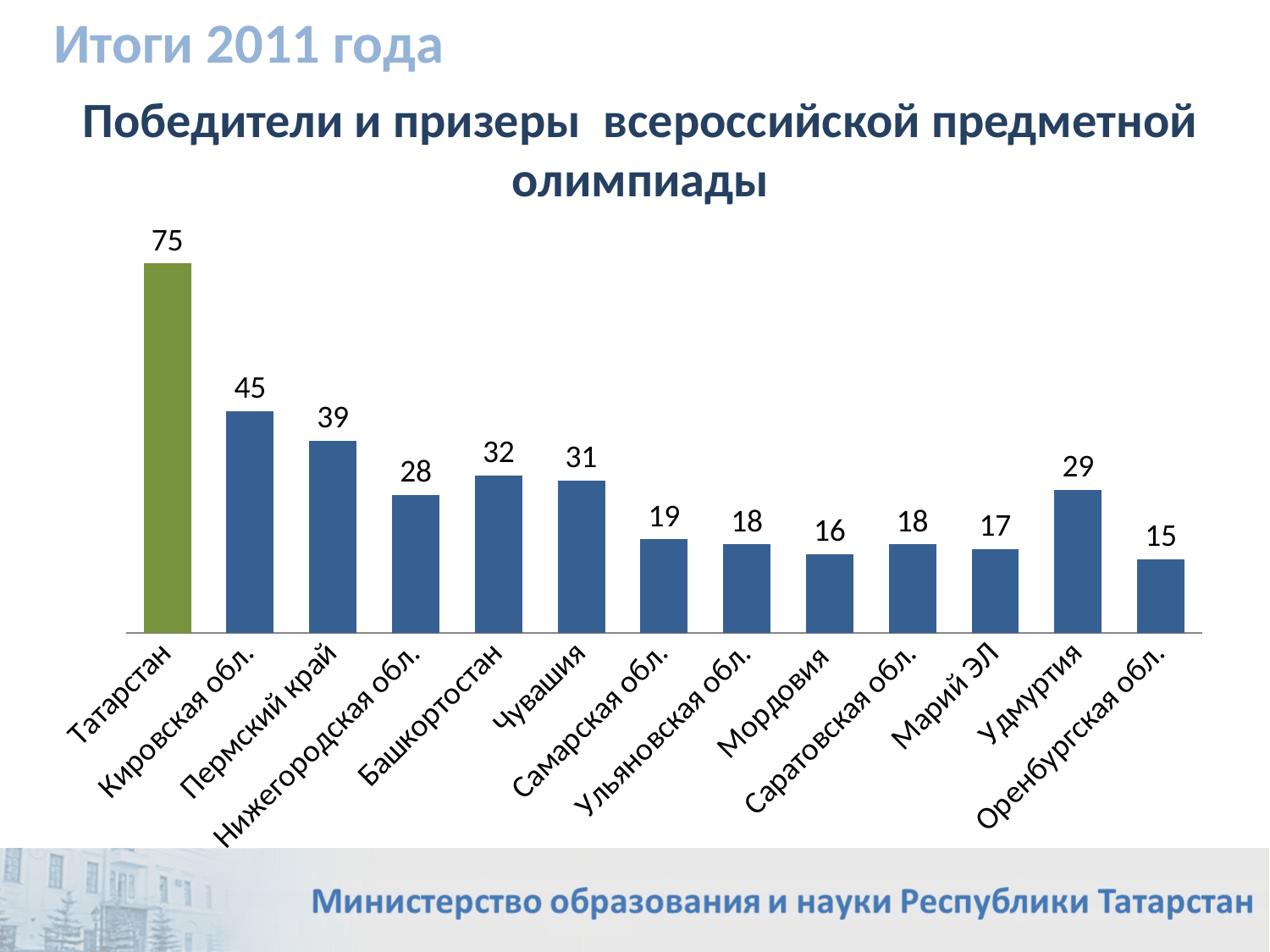
How many regions are shown on the chart? 13 What is the value for Татарстан? 75 What is the value for Удмуртия? 29 What kind of chart is shown on the slide? bar chart What is the difference between the values for Чувашия and Самарская обл.? 12 Which is larger, the value for Башкортостан or the value for Нижегородская обл.? Башкортостан What is the value for Пермский край? 39 Which region has the highest value? Татарстан Which region has the lowest value? Оренбургская обл. What is the difference between the values for Татарстан and Кировская обл.? 30 Which bar is shown in a different colour (green) from the others? Татарстан What is the value for Мордовия? 16